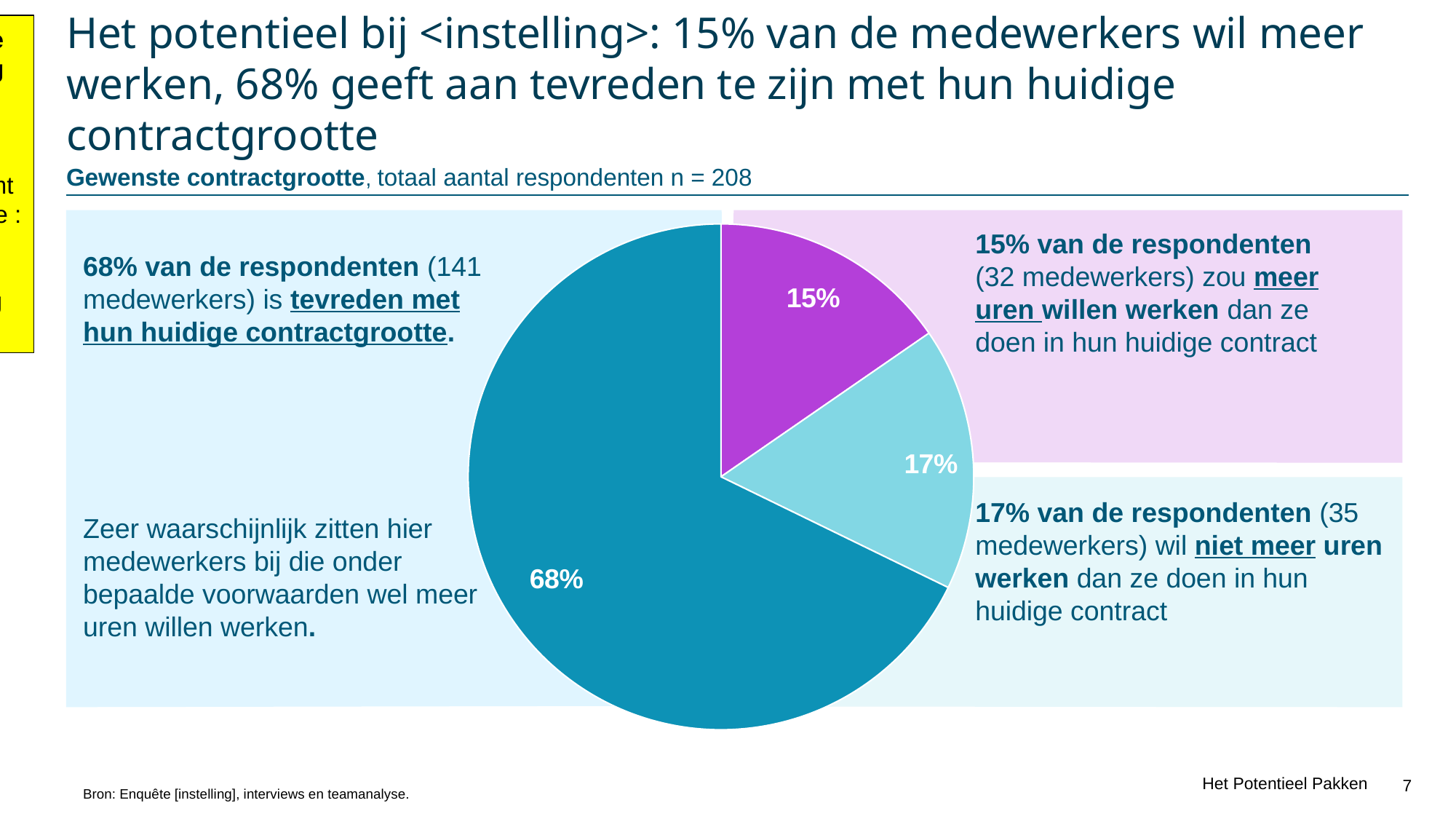
What kind of chart is shown on the slide? pie chart What share of respondents would like to work more hours (meer uren willen werken)? 15% Which slice of the pie chart is the largest? 68% (tevreden met huidige contractgrootte) What is the title of the chart above the pie? Gewenste contractgrootte What is the total number of respondents stated in the chart subtitle? 208 What share of respondents does not want to work more hours (niet meer uren werken)? 17% How many slices does the pie chart have? 3 Which is larger: the share that wants to work more hours or the share that does not want to work more hours? niet meer uren werken (17%) Is the share of respondents satisfied with their current contract size greater or less than 50%? greater What is the difference in percentage points between the largest slice and the smallest slice? 53 Which slice of the pie chart is the smallest? 15% (meer uren willen werken) What share of respondents is satisfied with their current contract size (tevreden met hun huidige contractgrootte)? 68%